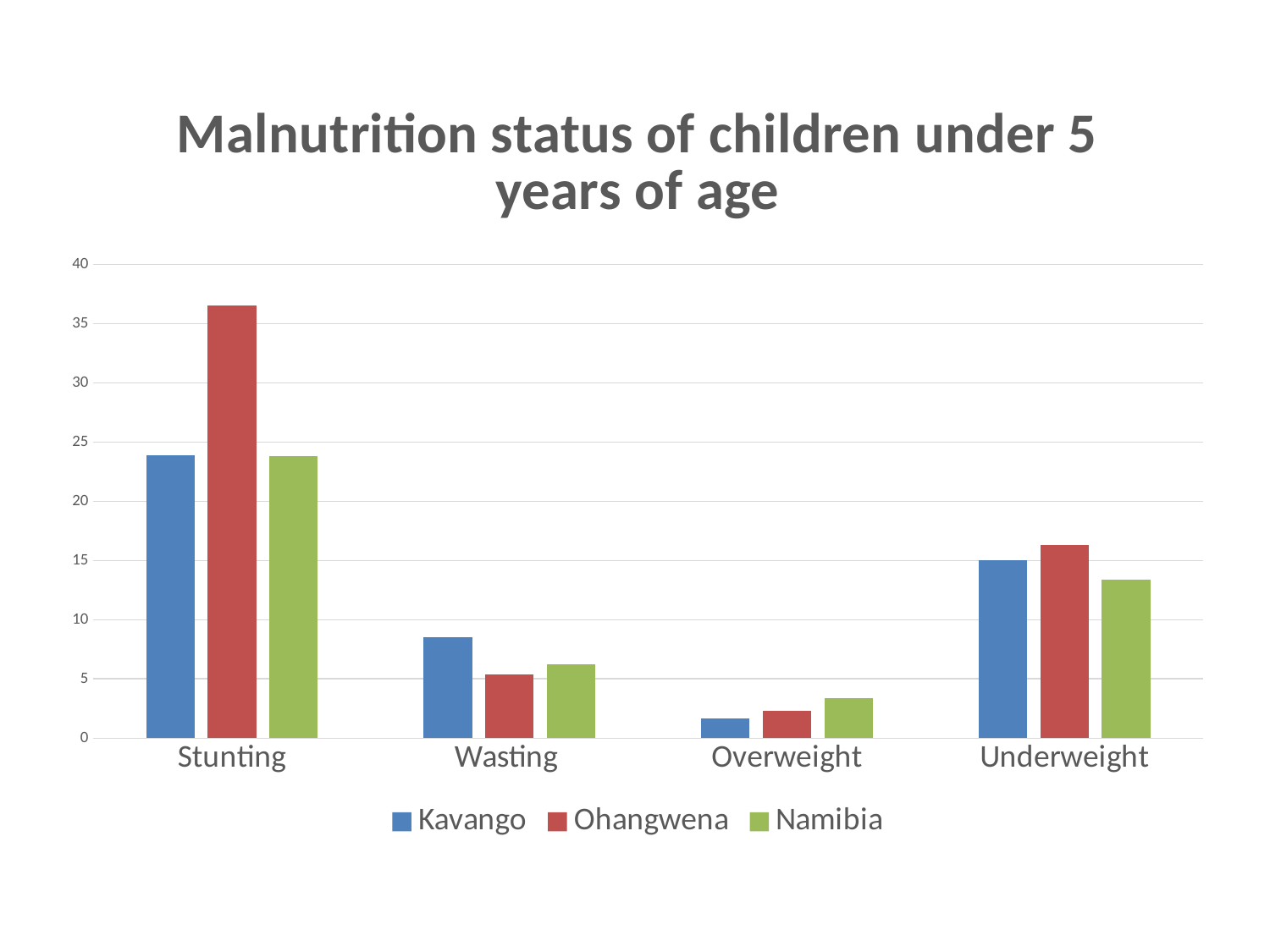
What kind of chart is shown on the slide? bar chart How many categories are shown on the x axis? 4 Which series has the highest value for Overweight? Namibia Which series has the highest value for Stunting? Ohangwena What is the title of the chart? Malnutrition status of children under 5 years of age Which series has the lowest value for Underweight? Namibia Is the value for Kavango in Wasting greater or less than 10? less Is the value for Ohangwena in Underweight greater or less than 15? greater Is the value for Ohangwena in Stunting greater or less than 35? greater Which series has the lowest value for Wasting? Ohangwena How many series does the legend list? 3 Which is larger: the Kavango value for Wasting or the Namibia value for Wasting? Kavango